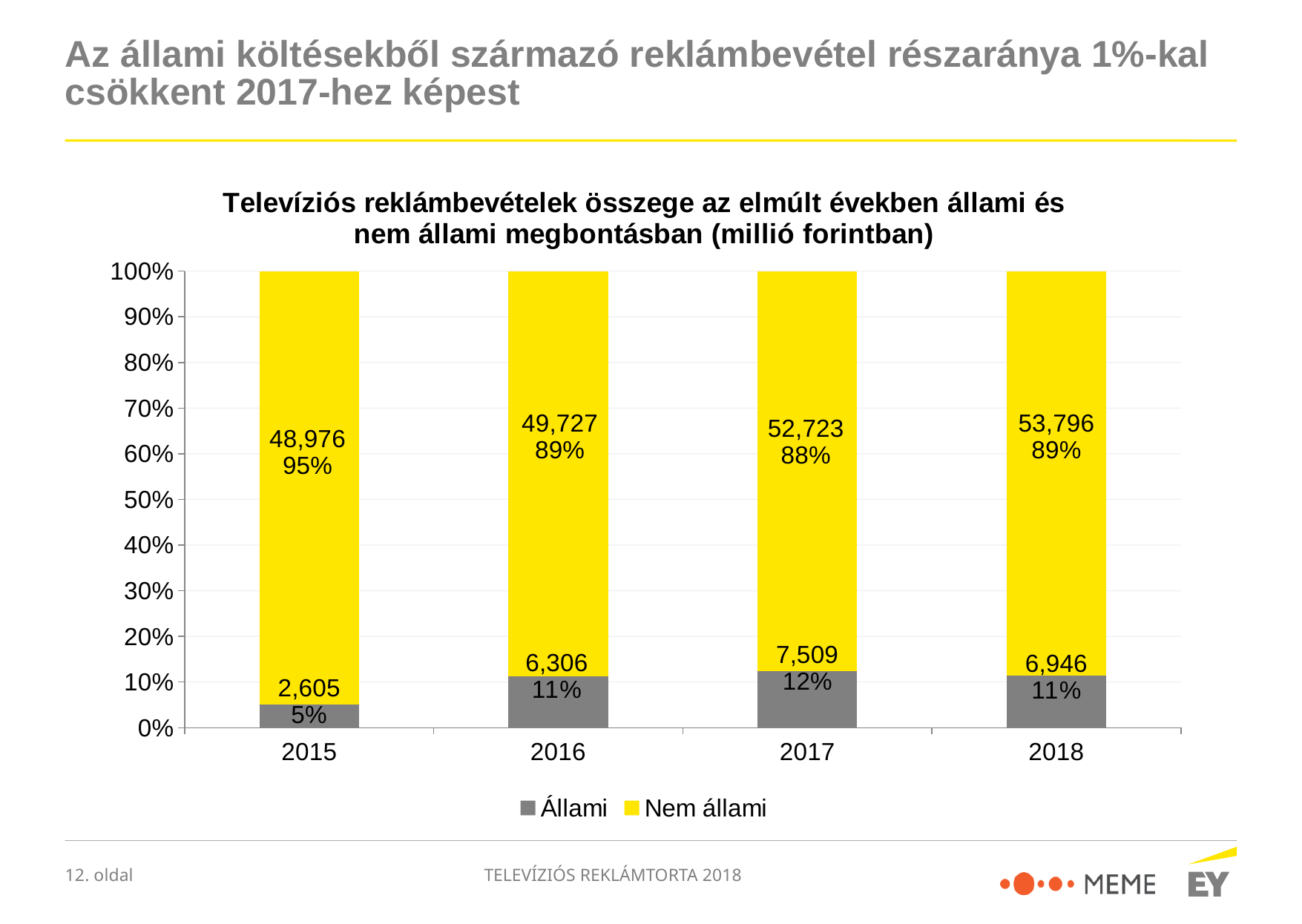
In which year is the Nem állami value highest? 2018 What kind of chart is shown on the slide? Stacked bar chart Which year has the larger Állami value, 2016 or 2018? 2018 In which year is the Állami value lowest? 2015 What is the value for Állami in 2017? 7,509 What is the value for Nem állami in 2018? 53,796 What is the total of the Állami and Nem állami values for 2015? 51,581 What is the difference between the Nem állami values for 2018 and 2017? 1,073 How many years are shown on the x axis? 4 What percentage share does Állami have in 2015? 5% How many series does the legend list? 2 Does the Nem állami value rise or fall from 2015 to 2018? Rise